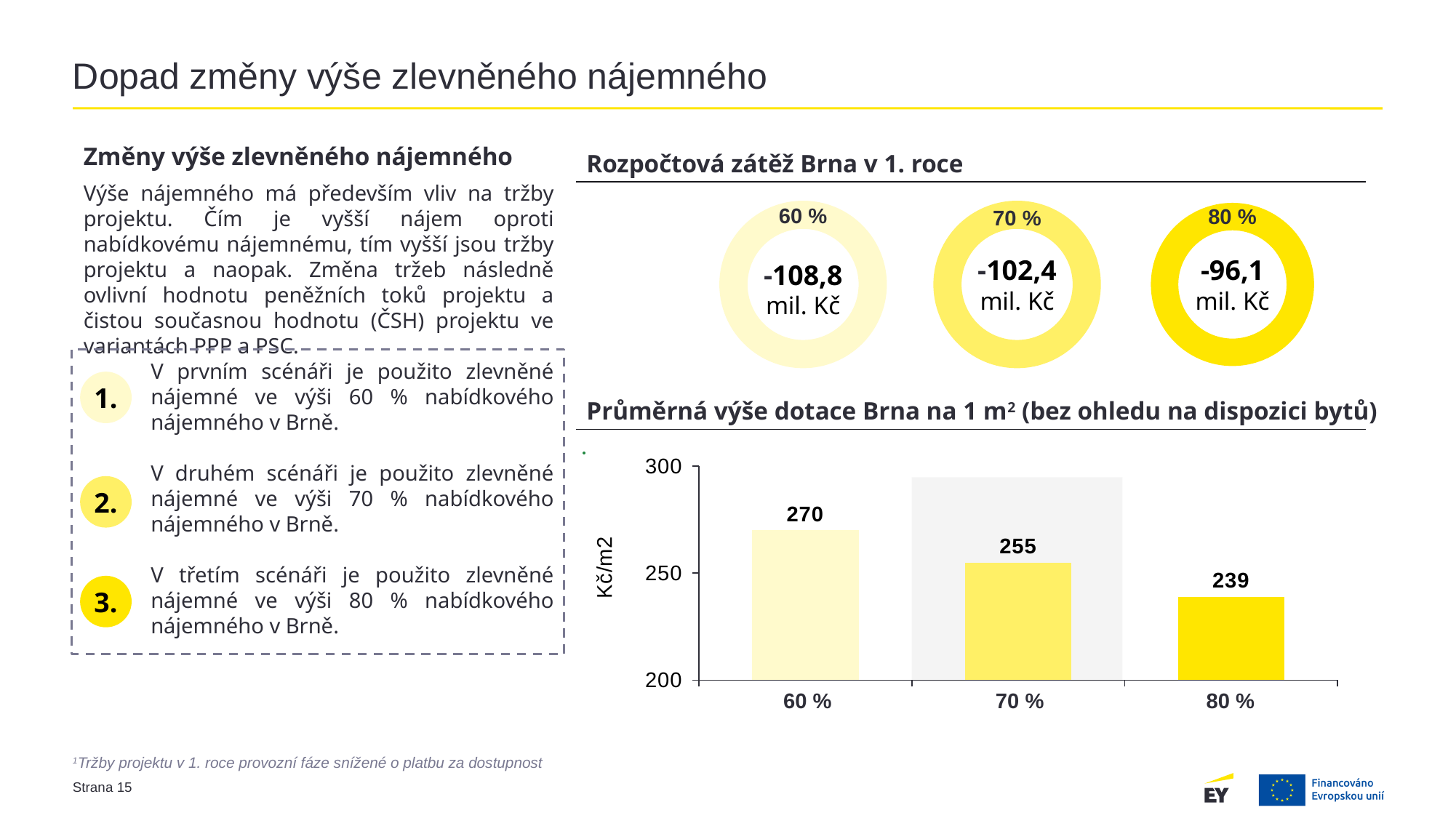
In the section 'Rozpočtová zátěž Brna v 1. roce', what value is shown for 70 %? -102,4 mil. Kč In the chart 'Průměrná výše dotace Brna na 1 m²', what is the value for 70 %? 255 In the chart 'Průměrná výše dotace Brna na 1 m²', what is the difference between the values for 60 % and 80 %? 31 In the chart 'Průměrná výše dotace Brna na 1 m²', which category has the lowest value? 80 % In the chart 'Průměrná výše dotace Brna na 1 m²', how many categories are shown on the x axis? 3 In the chart 'Průměrná výše dotace Brna na 1 m²', what is the value for 80 %? 239 In the chart 'Průměrná výše dotace Brna na 1 m²', which is larger, the value for 70 % or the value for 80 %? 70 % What kind of chart is 'Průměrná výše dotace Brna na 1 m²'? bar chart What is the y-axis label of the chart 'Průměrná výše dotace Brna na 1 m²'? Kč/m2 In the chart 'Průměrná výše dotace Brna na 1 m²', do the values rise or fall from 60 % to 80 %? fall In the chart 'Průměrná výše dotace Brna na 1 m²', what is the value for 60 %? 270 In the chart 'Průměrná výše dotace Brna na 1 m²', which category has the highest value? 60 %